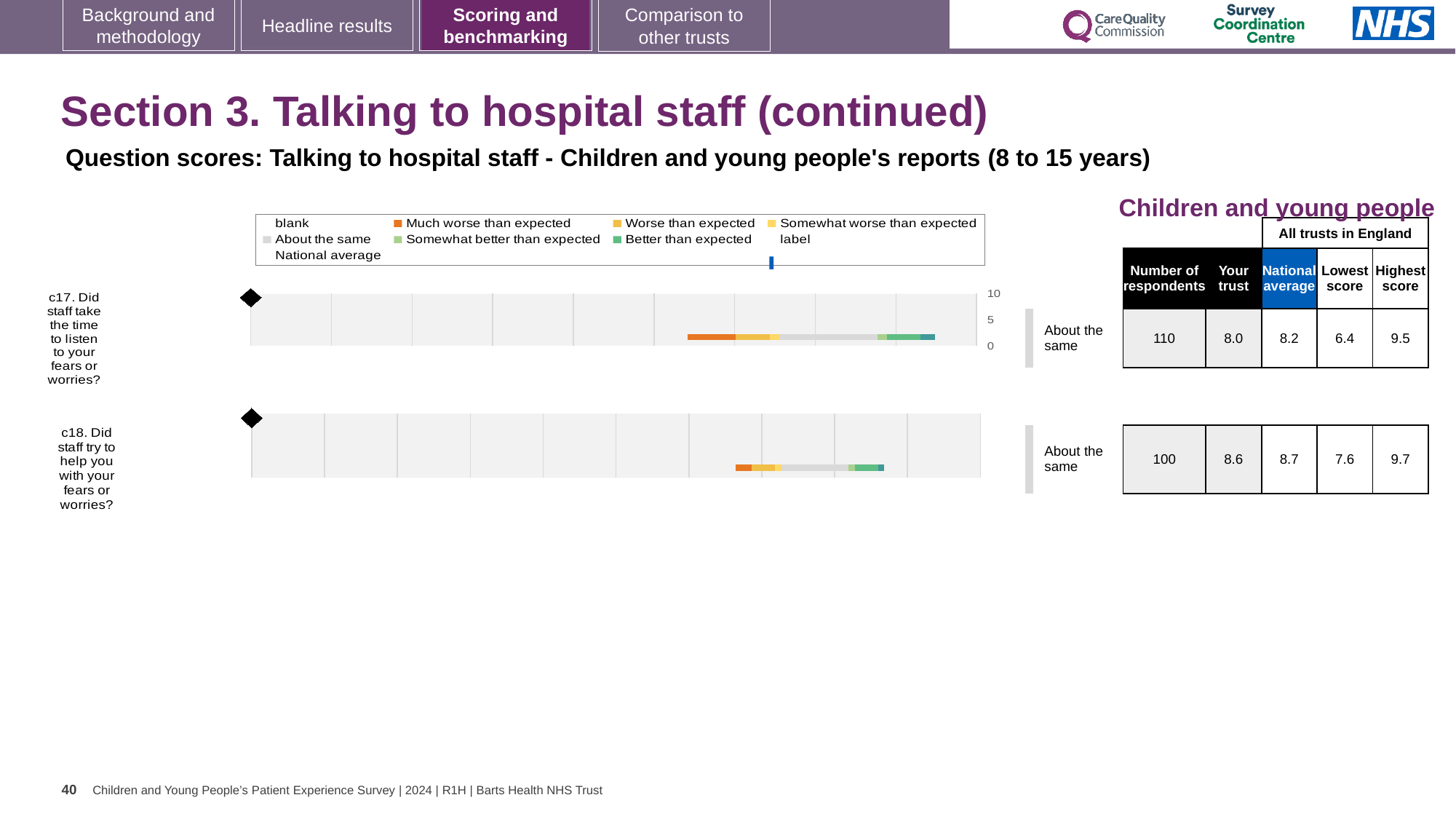
What kind of chart is used to show the benchmarking results for c17 and c18? bar chart How many entries does the chart legend list? 9 For c18 (Did staff try to help you with your fears or worries?), what is the national average score? 8.7 How many respondents answered c17? 110 What is the lowest score among all trusts in England for c17? 6.4 What benchmark category is shown for c18? About the same What is the highest score among all trusts in England for c18? 9.7 What is the difference between the highest and lowest trust scores for c17? 3.1 For c17 (Did staff take the time to listen to your fears or worries?), what is the 'Your trust' score? 8.0 What is the maximum value shown on the chart's score axis? 10 Which question has the higher 'Your trust' score, c17 or c18? c18 How many survey questions are plotted on the slide? 2